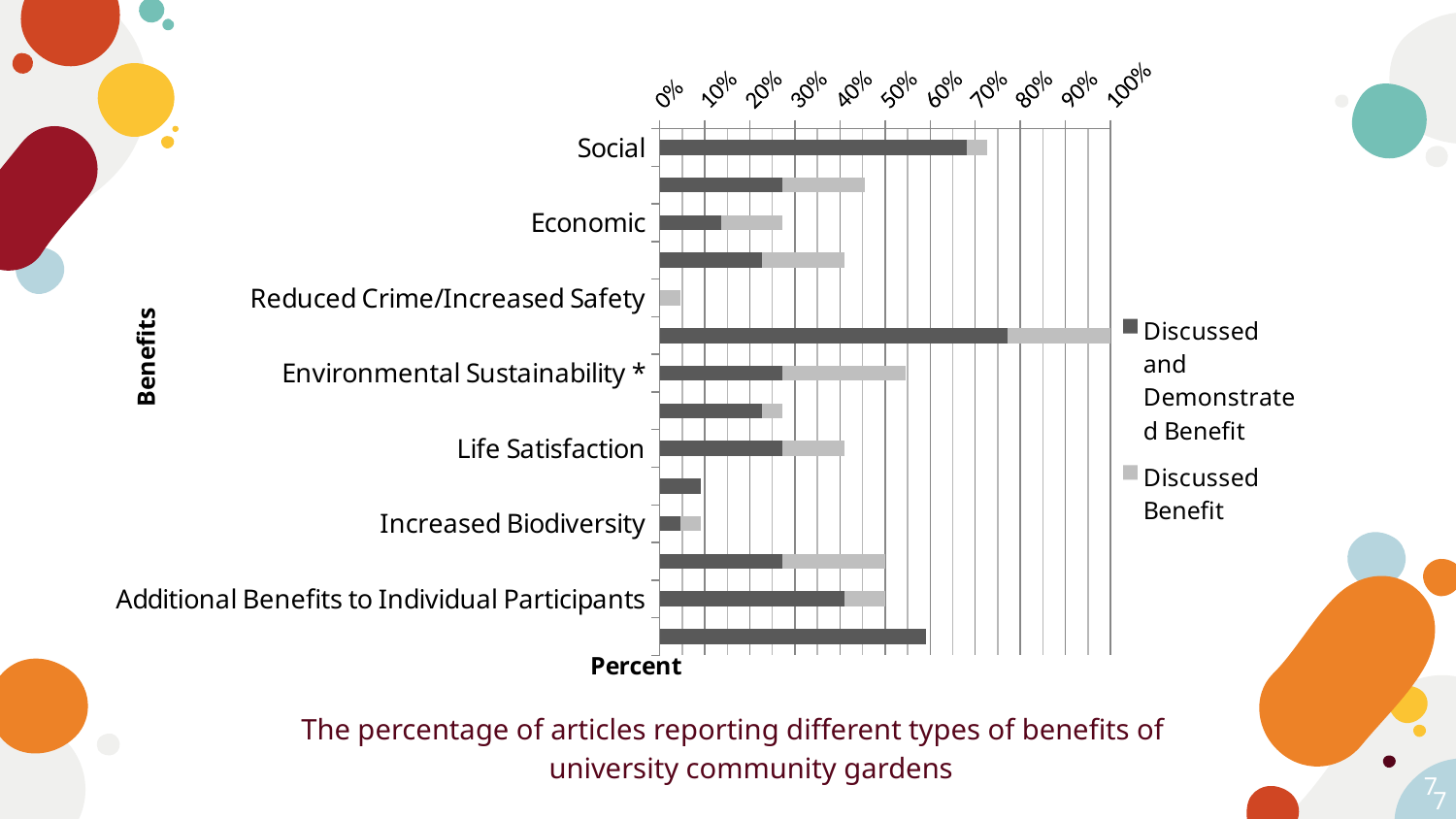
Is the total value of the Social bar greater or less than 60%? greater What kind of chart is shown on the slide? bar chart Is the total value of the Environmental Sustainability * bar greater or less than 50%? greater Is the total value of the Life Satisfaction bar greater or less than 50%? less What is the title of the horizontal axis? Percent Which has a larger total bar, Social or Economic? Social Which has a larger total bar, Environmental Sustainability * or Life Satisfaction? Environmental Sustainability * What are the two series named in the legend? Discussed and Demonstrated Benefit; Discussed Benefit How many series does the chart's legend list? 2